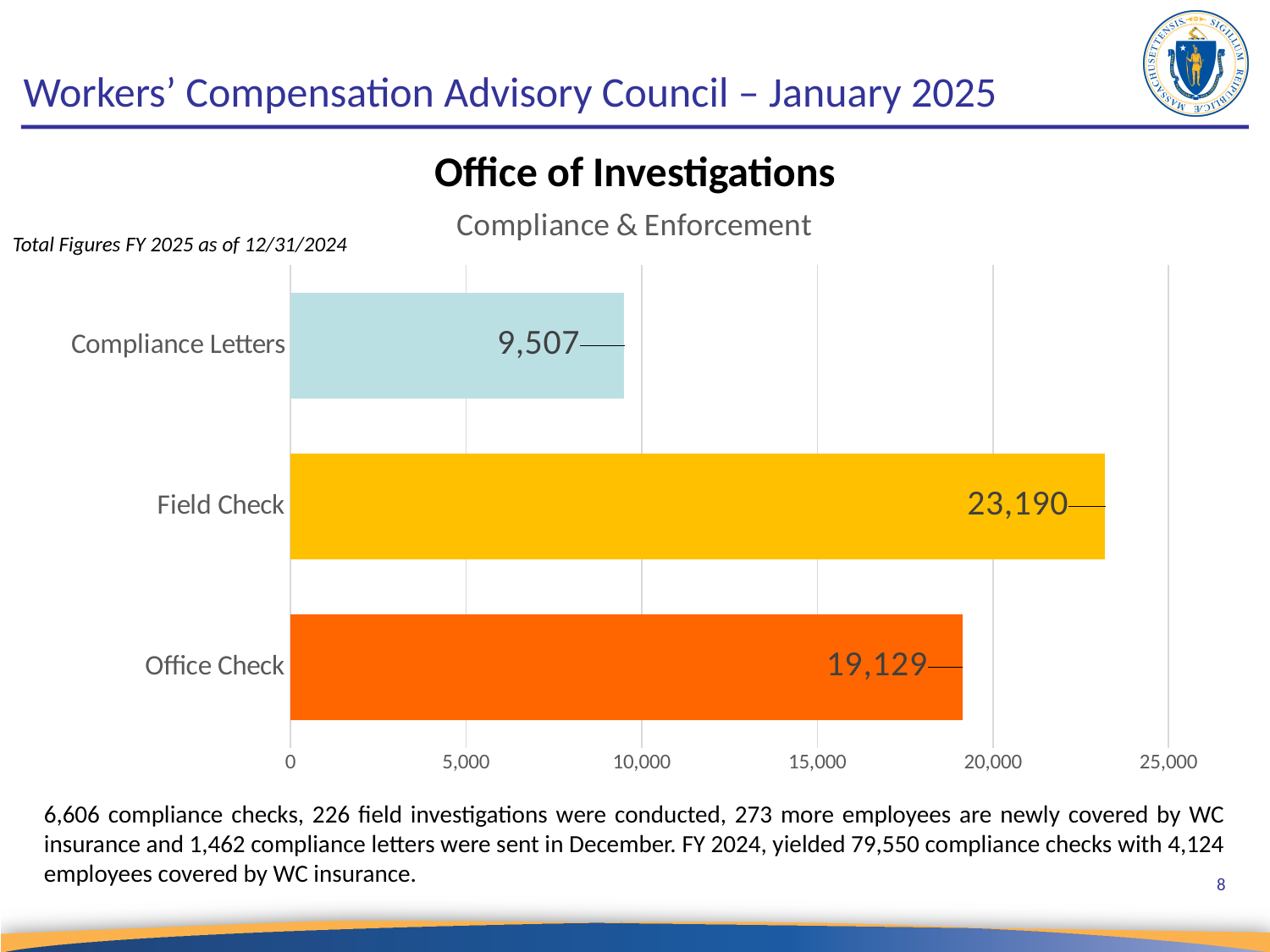
Is the value for Field Check greater or less than 20,000? greater Which category has the highest value in the Compliance & Enforcement chart? Field Check What is the difference between the Field Check and Office Check values? 4,061 What is the value for Office Check in the Compliance & Enforcement chart? 19,129 Which is larger, the value for Office Check or the value for Compliance Letters? Office Check What is the value for Field Check in the Compliance & Enforcement chart? 23,190 What kind of chart is the Compliance & Enforcement chart? bar chart Which category has the lowest value in the Compliance & Enforcement chart? Compliance Letters What is the title of the chart on the slide? Compliance & Enforcement How many categories are shown in the Compliance & Enforcement chart? 3 What is the difference between the Office Check and Compliance Letters values? 9,622 What is the value for Compliance Letters in the Compliance & Enforcement chart? 9,507